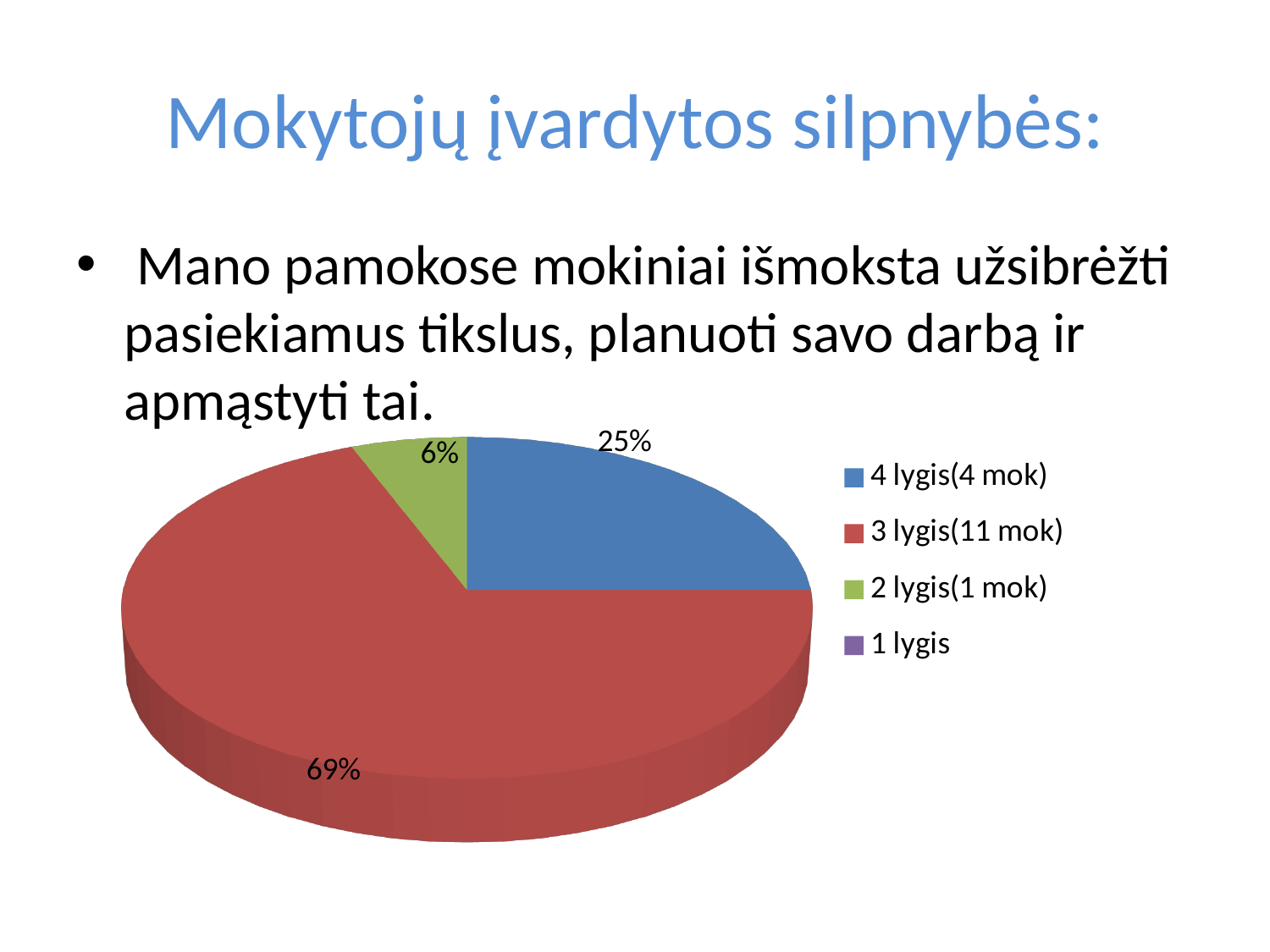
What kind of chart is shown on the slide? pie chart How many entries does the legend list? 4 Which legend entry is shown in blue? 4 lygis(4 mok) What colour is the "3 lygis(11 mok)" slice? red What is the difference in percentage points between the "3 lygis(11 mok)" slice and the "4 lygis(4 mok)" slice? 44% Which category has the largest slice of the pie? 3 lygis(11 mok) What share of the pie does the "3 lygis(11 mok)" slice represent? 69% What share of the pie does the "4 lygis(4 mok)" slice represent? 25% Is the share for "3 lygis(11 mok)" greater or less than 50%? greater Which slice is larger: "4 lygis(4 mok)" or "2 lygis(1 mok)"? 4 lygis(4 mok) Which of the labelled slices is the smallest? 2 lygis(1 mok) What share of the pie does the "2 lygis(1 mok)" slice represent? 6%